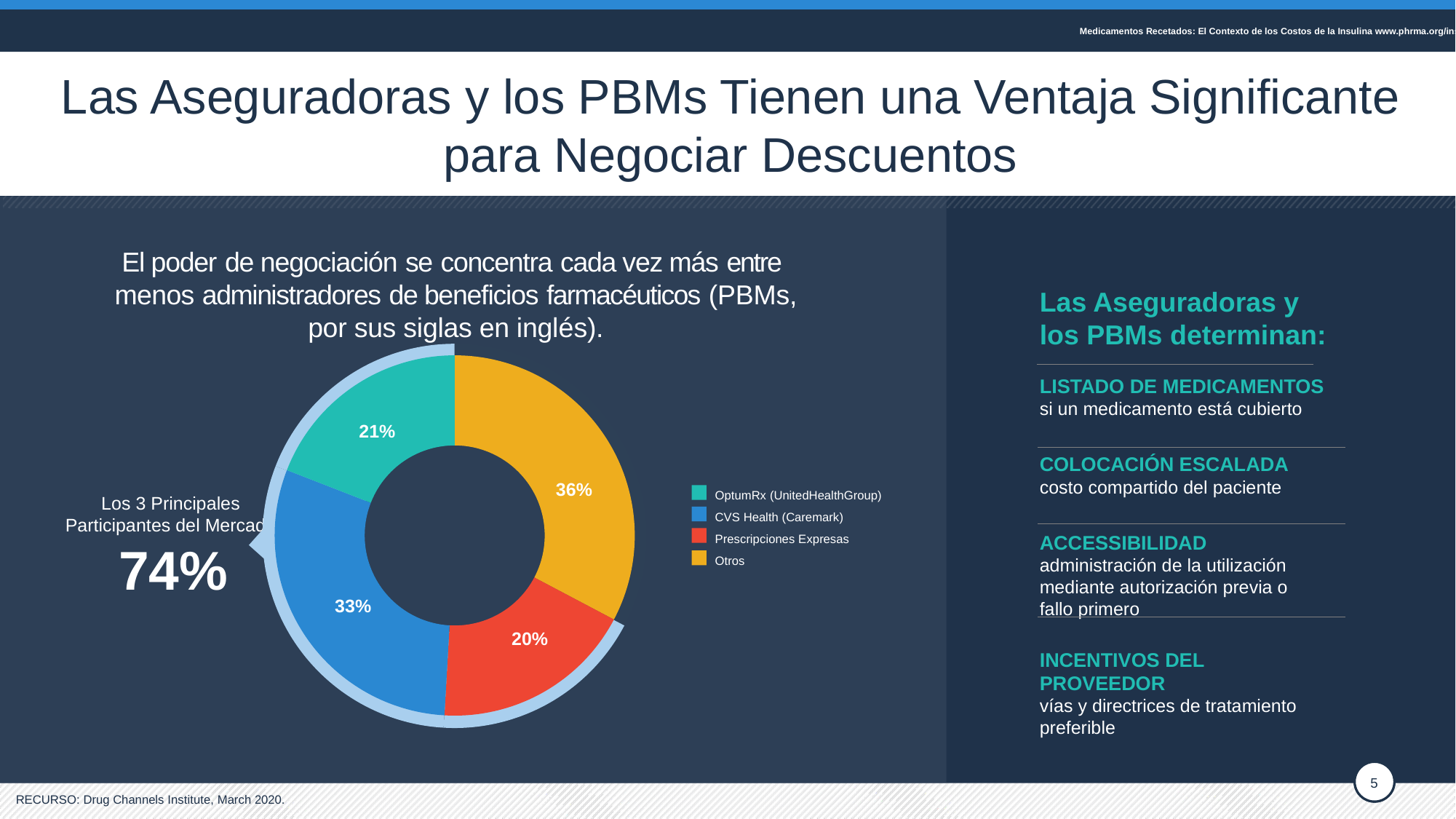
Which slice of the pie is the largest? Otros What share of the pie does Otros hold? 36% Which is larger, the share for Otros or the share for CVS Health (Caremark)? Otros Which slice of the pie is the smallest? Prescripciones Expresas What share of the pie does CVS Health (Caremark) hold? 33% What colour is the slice for Otros? Yellow What is the difference between the shares of CVS Health (Caremark) and OptumRx (UnitedHealthGroup)? 12% What share of the pie does OptumRx (UnitedHealthGroup) hold? 21% What kind of chart is shown on the slide? Pie chart (donut) How many slices does the pie chart have? 4 What share of the pie does Prescripciones Expresas hold? 20% What is the combined share of the three named PBMs (OptumRx, CVS Health and Prescripciones Expresas)? 74%